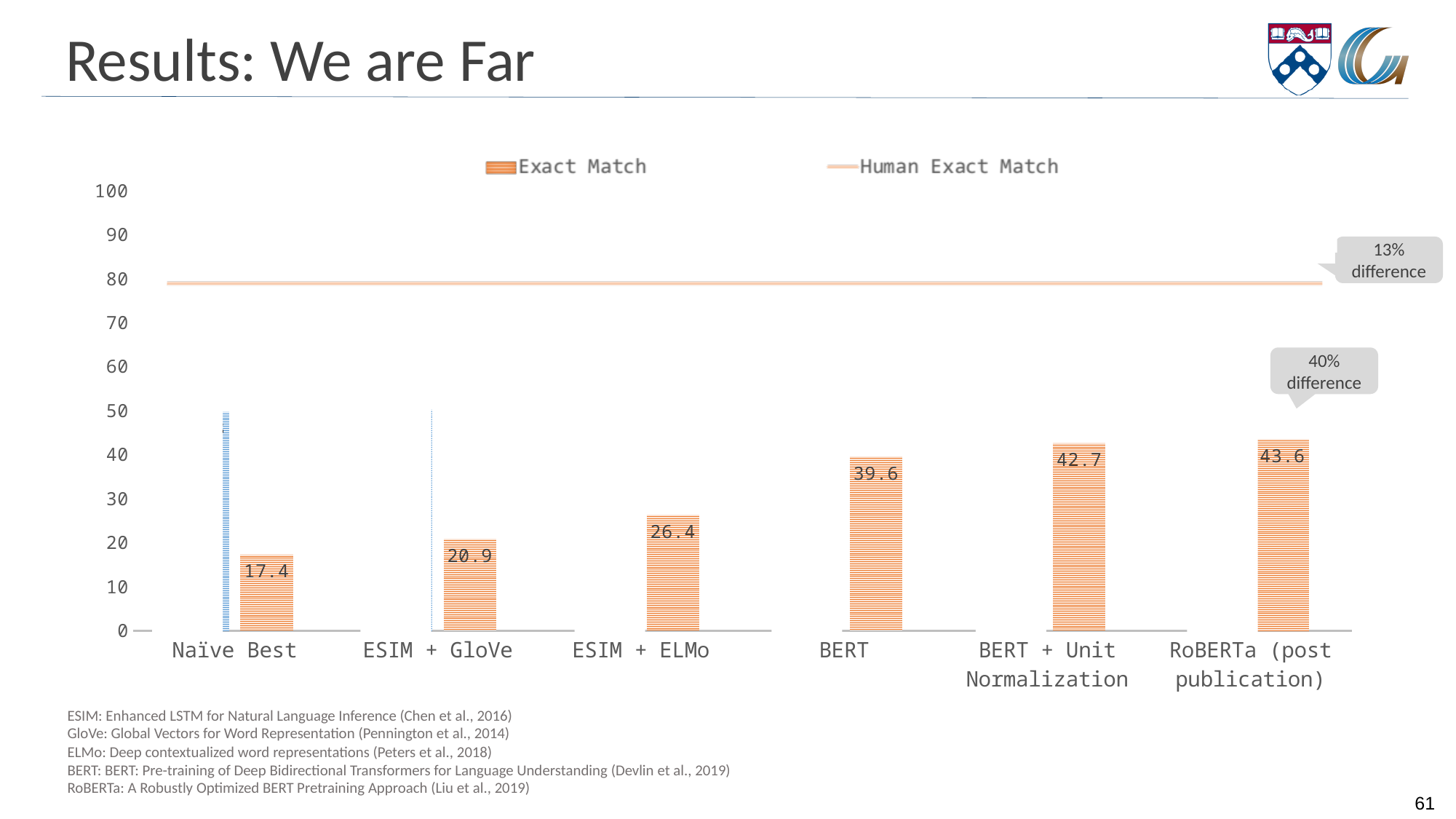
What is the Exact Match value for BERT? 39.6 How many series does the legend list? 2 What is the difference in Exact Match between BERT + Unit Normalization and BERT? 3.1 Which model has the lowest Exact Match score? Naïve Best What kind of chart is used to show the Exact Match scores? Bar chart Is the Human Exact Match line greater or less than 70? greater How many models are shown on the x axis? 6 Which has a higher Exact Match score, ESIM + GloVe or ESIM + ELMo? ESIM + ELMo What is the Exact Match value for ESIM + ELMo? 26.4 What is the Exact Match value for Naïve Best? 17.4 Which model has the highest Exact Match score? RoBERTa (post publication) Do the Exact Match values rise or fall from left to right along the x axis? Rise